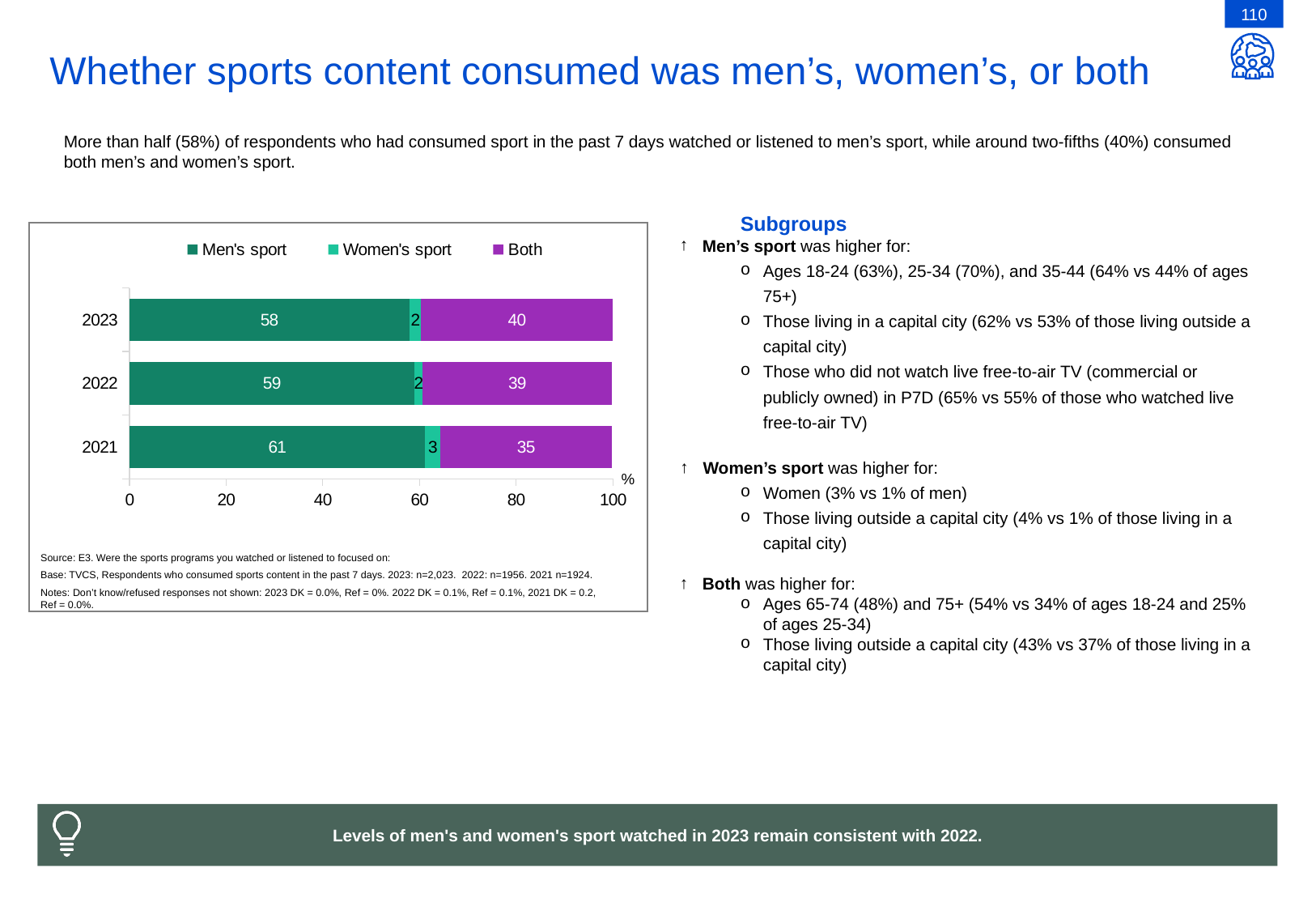
Which year has the lowest value for Both? 2021 Is the value for Both larger in 2023 or in 2021? 2023 How many years are shown on the chart? 3 How many series does the legend list? 3 Which year has the highest value for Men's sport? 2021 What is the difference between the Men's sport value in 2021 and in 2023? 3 What is the value for Both in 2021? 35 What kind of chart is shown on the slide? Stacked bar chart Which series is shown in purple in the chart? Both What is the value for Men's sport in 2023? 58 What is the total of the stacked bar for 2022? 100 What is the value for Women's sport in 2022? 2